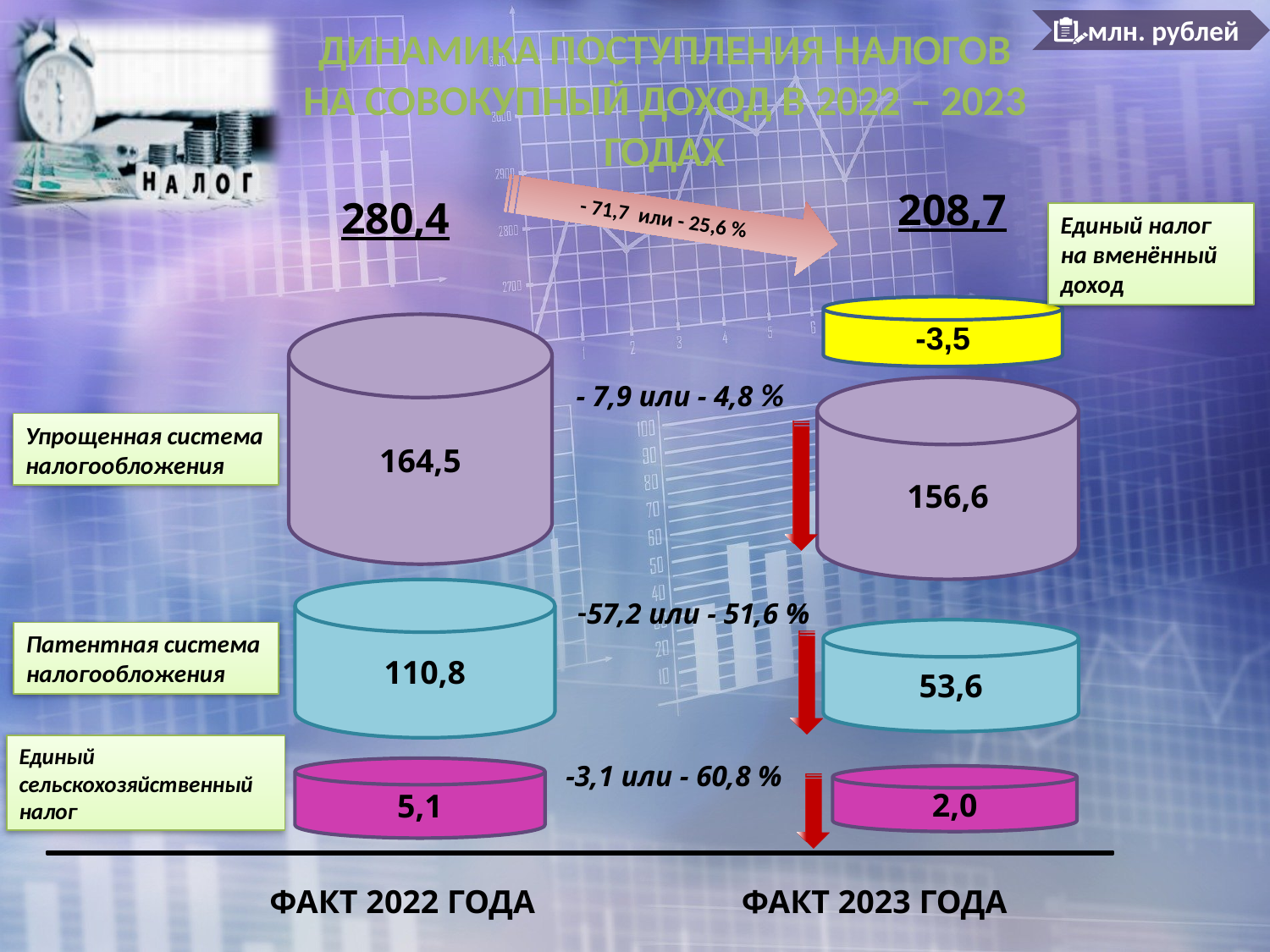
Which tax category has the highest value in ФАКТ 2022 ГОДА? Упрощенная система налогообложения What is the total shown for ФАКТ 2023 ГОДА? 208,7 In what units are the values on the slide given? млн. рублей What is the value for Единый сельскохозяйственный налог in ФАКТ 2023 ГОДА? 2,0 What is the value for Единый налог на вменённый доход in ФАКТ 2023 ГОДА? -3,5 What is the value for Патентная система налогообложения in ФАКТ 2022 ГОДА? 110,8 What is the total shown for ФАКТ 2022 ГОДА? 280,4 What is the value for Упрощенная система налогообложения in ФАКТ 2023 ГОДА? 156,6 What is the value for Упрощенная система налогообложения in ФАКТ 2022 ГОДА? 164,5 Which tax category has the lowest value in ФАКТ 2023 ГОДА? Единый налог на вменённый доход By how much did Патентная система налогообложения change from 2022 to 2023? -57,2 или -51,6 % What is the value for Патентная система налогообложения in ФАКТ 2023 ГОДА? 53,6